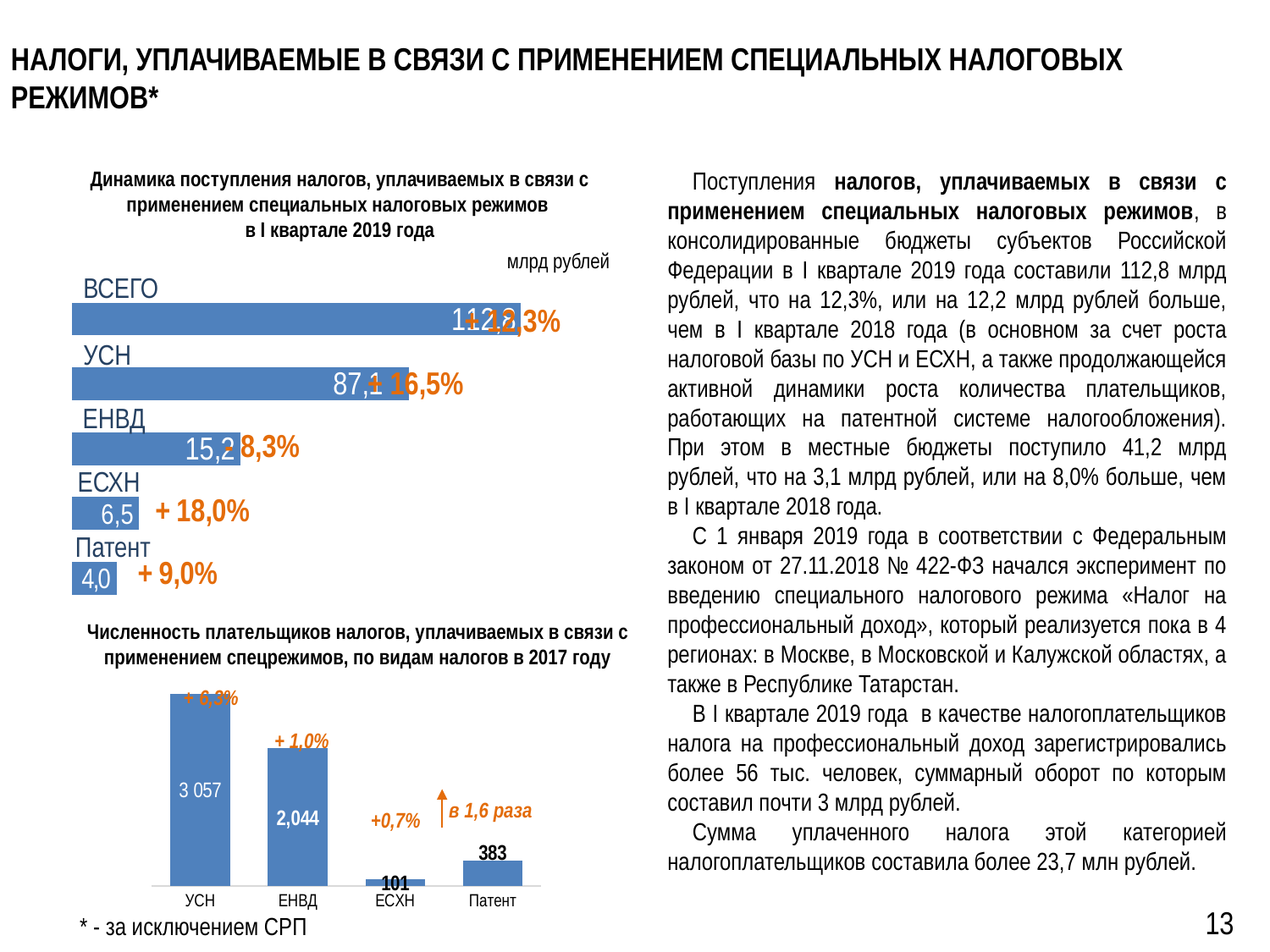
In the bottom chart (Численность плательщиков налогов), what is the value for УСН? 3 057 In the bottom chart (Численность плательщиков налогов), what is the value for Патент? 383 In the top chart (Динамика поступления налогов), what is the value for ЕНВД? 15,2 In the top chart (Динамика поступления налогов), what growth percentage is shown next to ЕСХН? + 18,0% In the top chart (Динамика поступления налогов), what is the difference between the values for ЕНВД and ЕСХН? 8,7 In the top chart (Динамика поступления налогов), which category has the lowest value? Патент In the top chart (Динамика поступления налогов), what unit is stated for the values? млрд рублей In the bottom chart (Численность плательщиков налогов), which category has the lowest value? ЕСХН In the top chart (Динамика поступления налогов), what is the value for УСН? 87,1 In the top chart (Динамика поступления налогов), which category other than ВСЕГО has the highest value? УСН In the top chart (Динамика поступления налогов), what is the value for Патент? 4,0 What type of chart is the bottom chart (Численность плательщиков налогов)? Bar chart